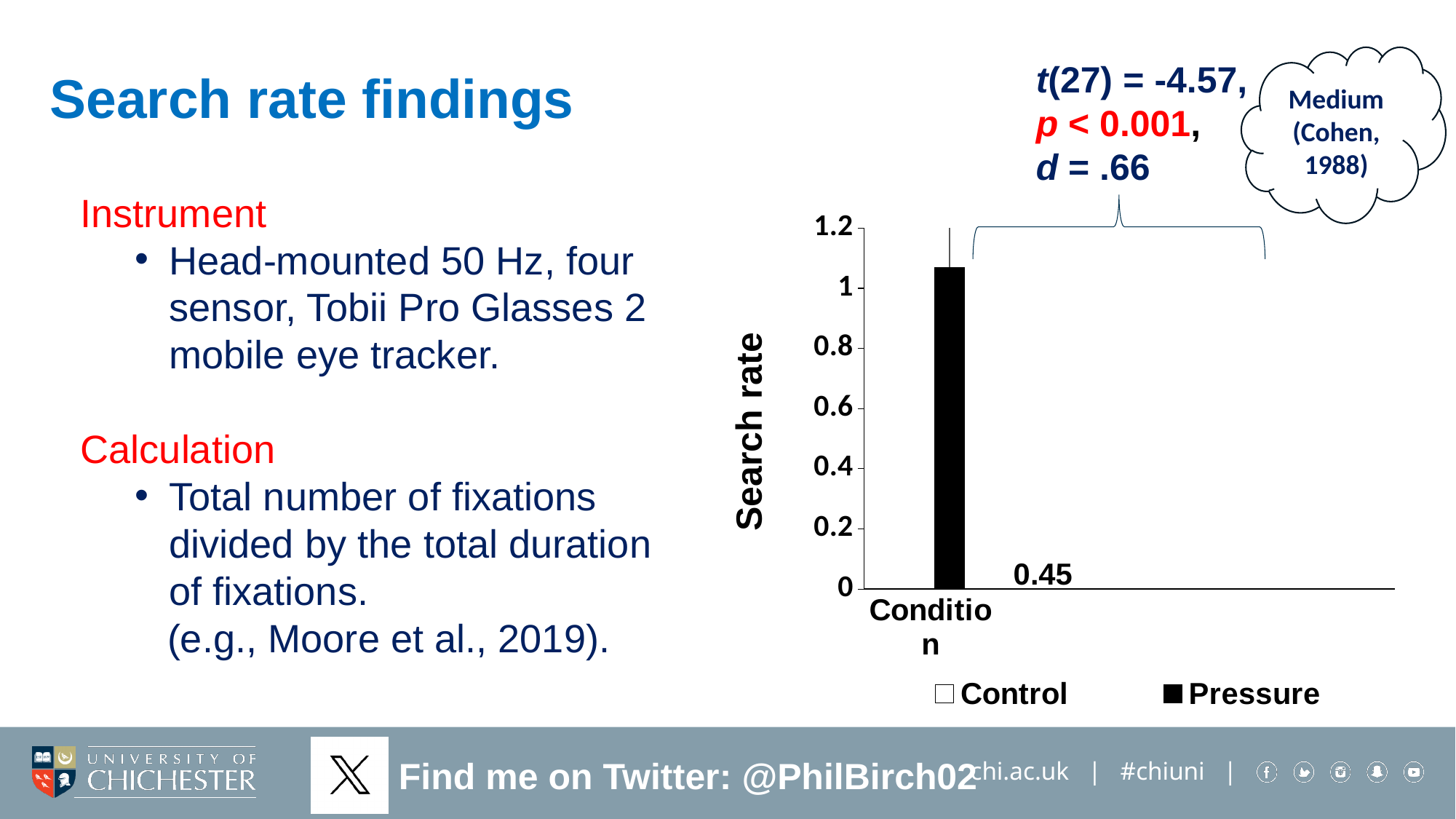
Is the value of the Pressure bar greater or less than 1.2? less What is the lowest value shown on the chart's vertical axis? 0 What is the highest value shown on the chart's vertical axis? 1.2 What are the two series named in the chart legend? Control and Pressure What kind of chart is shown on the slide? bar chart How many series does the chart legend list? 2 What is the title of the chart's vertical axis? Search rate Is the value of the Pressure bar greater or less than 0.8? greater Is the value of the Pressure bar greater or less than 1? greater